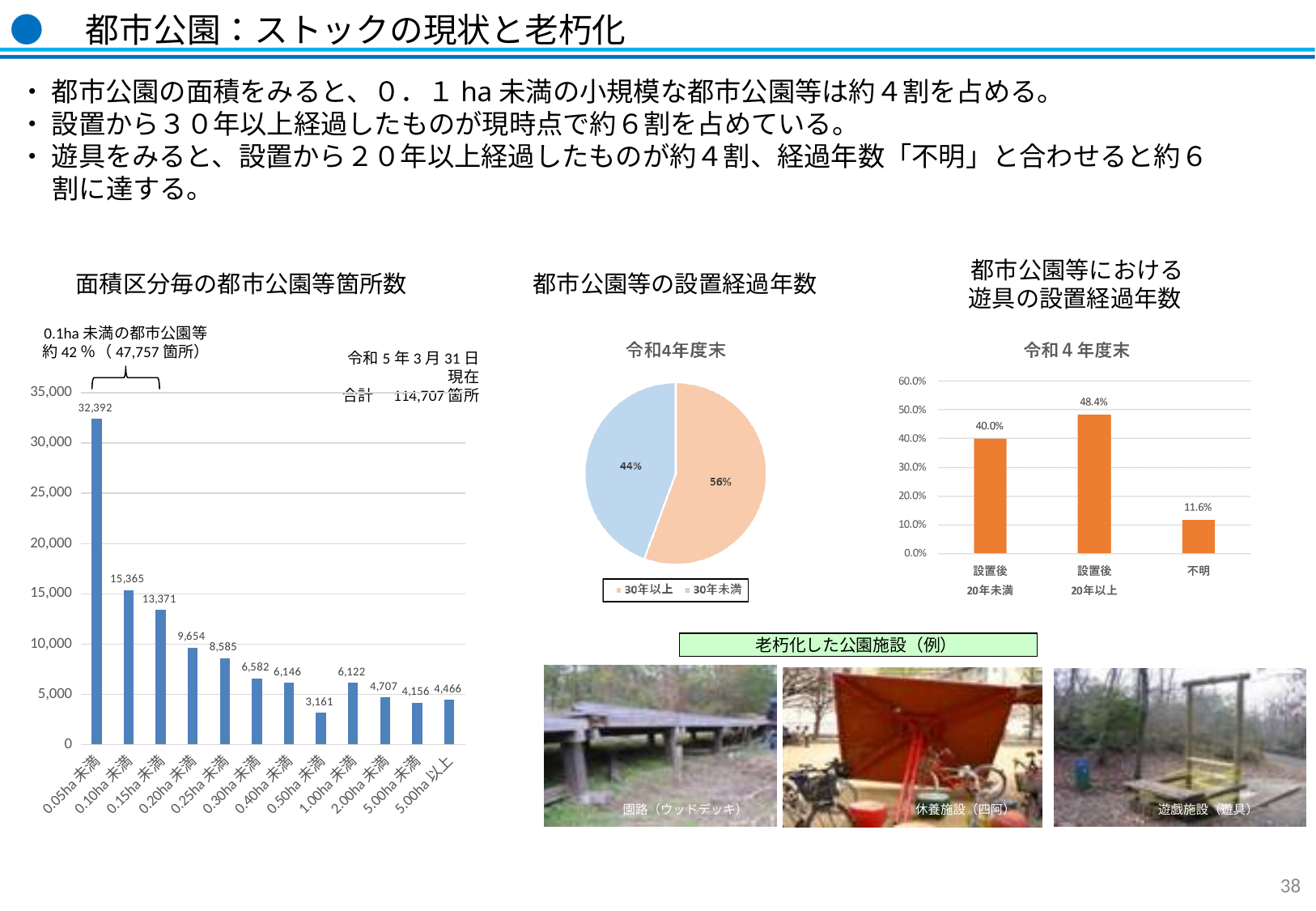
In the chart titled 面積区分毎の都市公園等箇所数, what is the value for 5.00ha以上? 4,466 In the pie chart titled 都市公園等の設置経過年数, what share is 30年以上? 56% In the chart titled 面積区分毎の都市公園等箇所数, what is the difference between the values for 0.10ha未満 and 0.15ha未満? 1,994 In the chart titled 都市公園等における遊具の設置経過年数, what is the value for 不明? 11.6% In the chart titled 面積区分毎の都市公園等箇所数, how many categories are shown on the x axis? 12 What kind of chart is the one titled 都市公園等の設置経過年数? pie chart In the chart titled 都市公園等における遊具の設置経過年数, which category has the highest value? 設置後20年以上 In the chart titled 都市公園等における遊具の設置経過年数, what is the difference between 設置後20年以上 and 設置後20年未満? 8.4% How many series does the legend of the pie chart titled 都市公園等の設置経過年数 list? 2 In the chart titled 面積区分毎の都市公園等箇所数, which category has the lowest value? 0.50ha未満 In the chart titled 面積区分毎の都市公園等箇所数, what is the value for 0.05ha未満? 32,392 In the chart titled 面積区分毎の都市公園等箇所数, which is larger, the value for 1.00ha未満 or the value for 2.00ha未満? 1.00ha未満